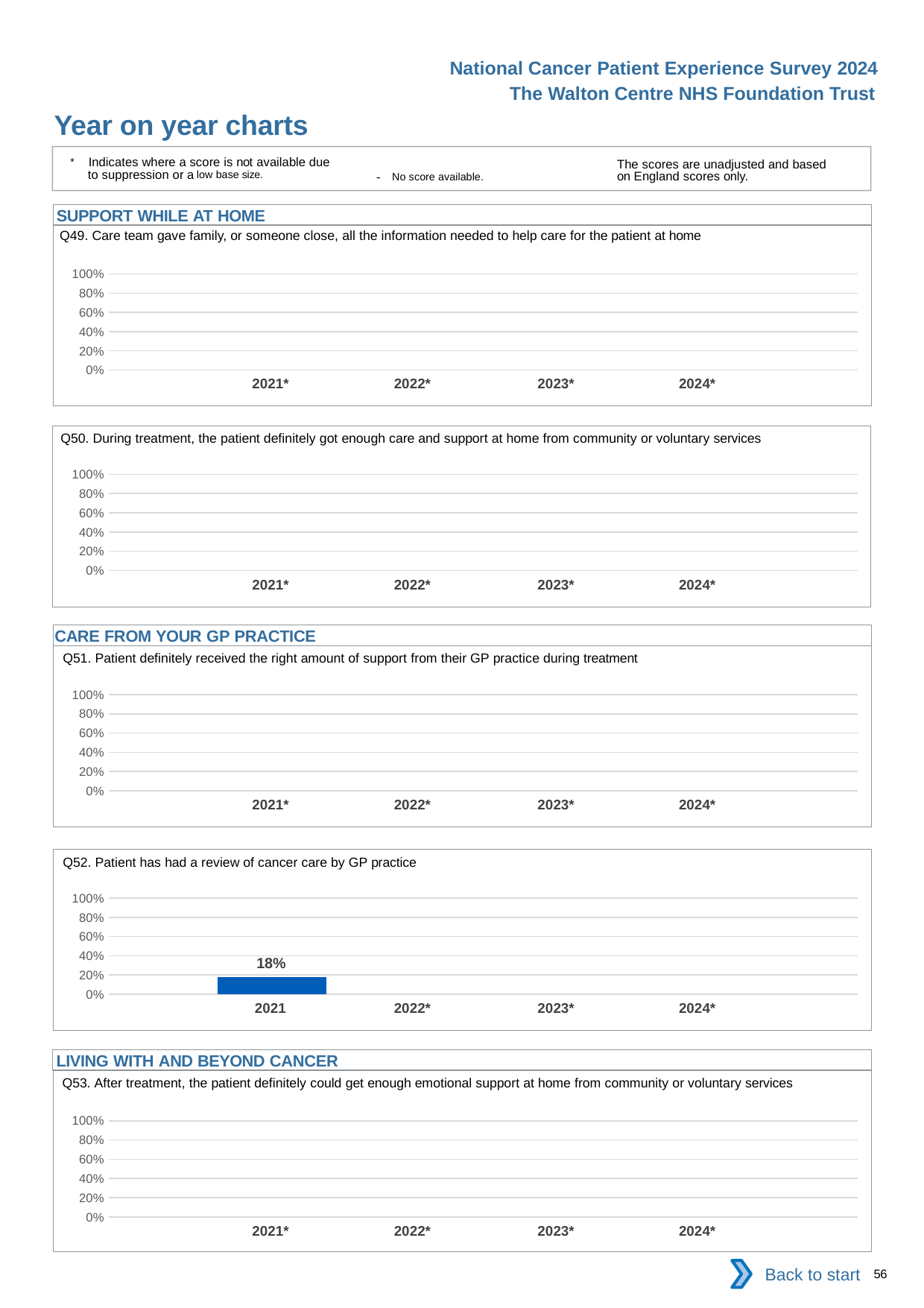
In the Q52 chart (Patient has had a review of cancer care by GP practice), how many years have a plotted bar? 1 How many year categories are shown on the x axis of the Q52 chart (Patient has had a review of cancer care by GP practice)? 4 How many charts are shown on the slide? 5 In the Q52 chart (Patient has had a review of cancer care by GP practice), is the value for 2021 greater or less than 40%? less In the Q50 chart (During treatment, the patient definitely got enough care and support at home from community or voluntary services), how many years have a plotted bar? 0 In the Q52 chart (Patient has had a review of cancer care by GP practice), what is the value for 2021? 18% What is the highest value shown on the y axis of the Q53 chart (After treatment, the patient definitely could get enough emotional support at home from community or voluntary services)? 100% In the Q52 chart (Patient has had a review of cancer care by GP practice), is the value for 2021 greater or less than 20%? less What kind of chart is the Q52 chart (Patient has had a review of cancer care by GP practice)? bar chart In the Q52 chart (Patient has had a review of cancer care by GP practice), which year is the only one with a score shown? 2021